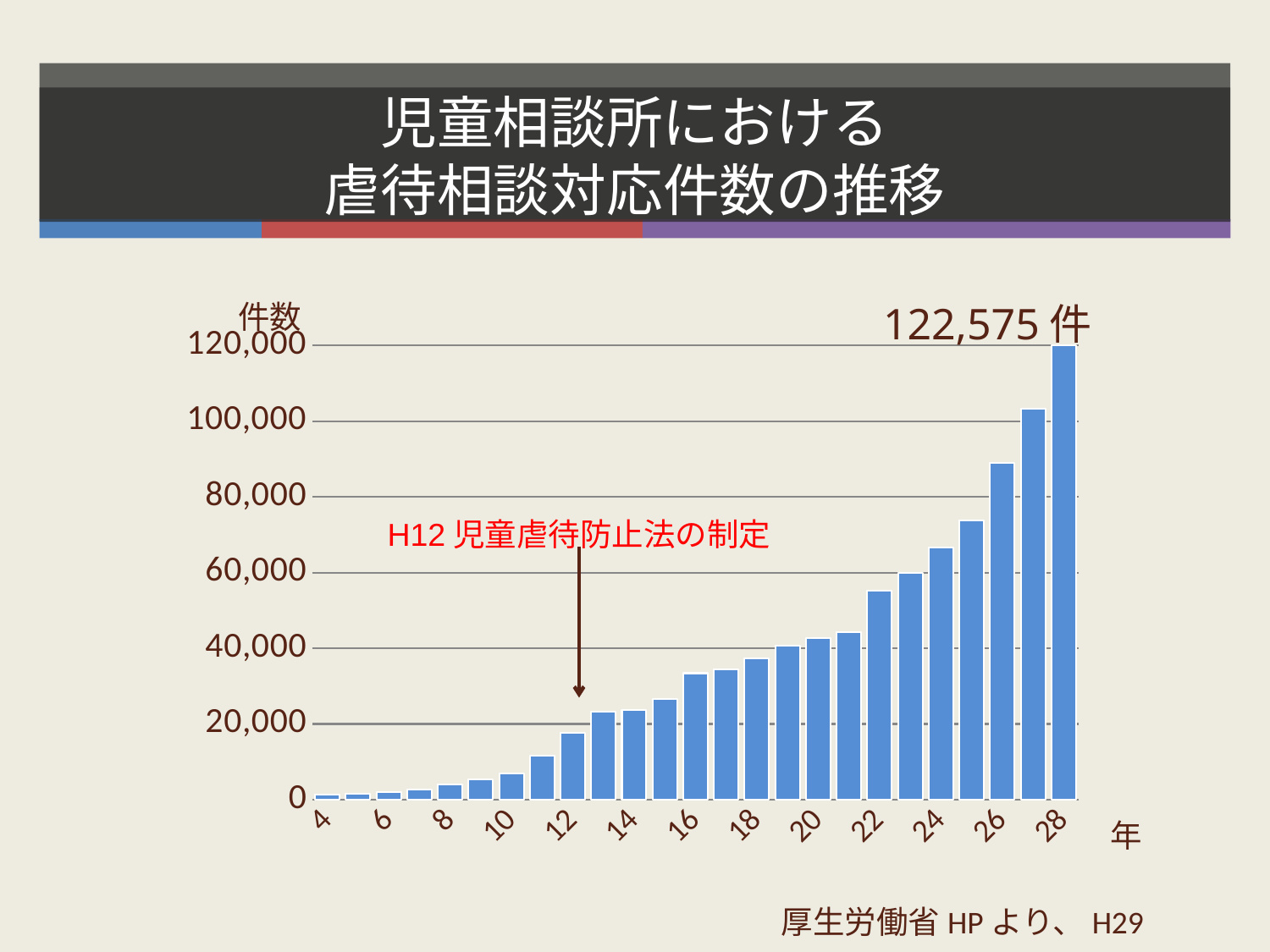
Is the value for year 26 greater or less than 80,000? greater What value is labelled on the bar for year 28? 122,575 件 Which is larger, the value for year 26 or the value for year 22? year 26 What event does the red annotation with the arrow mark on the chart? H12 児童虐待防止法の制定 What kind of chart is shown on the slide? bar chart Which year has the highest number of cases? 28 Is the value for year 22 greater or less than 40,000? greater Which year has the lowest number of cases? 4 Do the values rise or fall as the years increase along the x axis? rise Is the value for year 12 greater or less than 20,000? less How many bars are plotted in the chart? 25